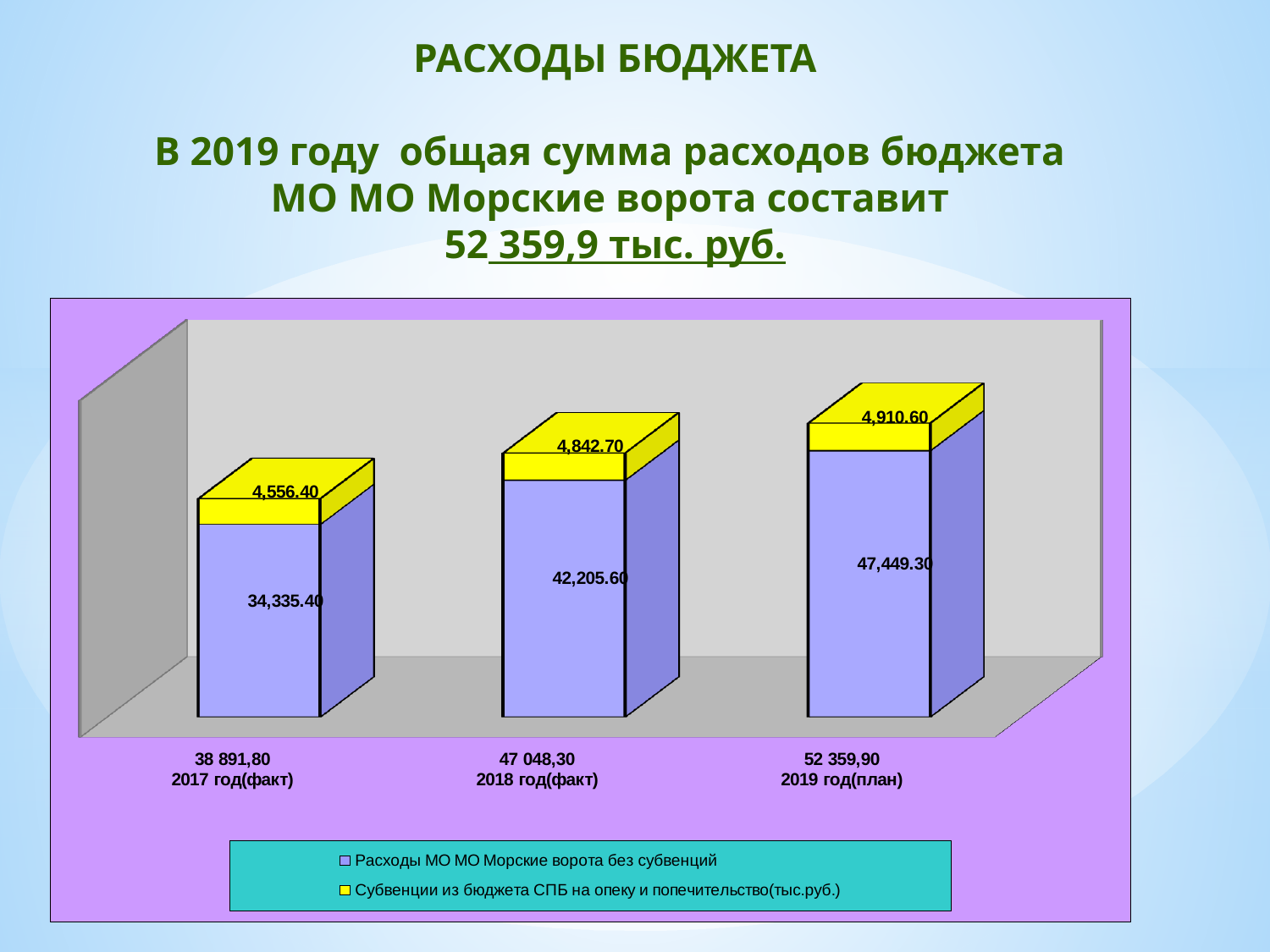
What is the value of 'Расходы МО МО Морские ворота без субвенций' for 2017 год(факт)? 34,335.40 What type of chart is shown on the slide? bar chart Which year has the highest value for 'Расходы МО МО Морские ворота без субвенций'? 2019 год(план) Do the values for 'Расходы МО МО Морские ворота без субвенций' rise or fall from 2017 to 2019? rise What is the difference between the 'Расходы МО МО Морские ворота без субвенций' values for 2019 год(план) and 2018 год(факт)? 5,243.70 Which year has the lowest value for 'Субвенции из бюджета СПБ на опеку и попечительство(тыс.руб.)'? 2017 год(факт) What is the total of the stacked bar for 2018 год(факт)? 47 048,30 How many categories (years) are shown on the x axis? 3 What is the value of 'Субвенции из бюджета СПБ на опеку и попечительство(тыс.руб.)' for 2019 год(план)? 4,910.60 What is the value of 'Расходы МО МО Морские ворота без субвенций' for 2019 год(план)? 47,449.30 How many series does the legend list? 2 What is the value of 'Субвенции из бюджета СПБ на опеку и попечительство(тыс.руб.)' for 2018 год(факт)? 4,842.70